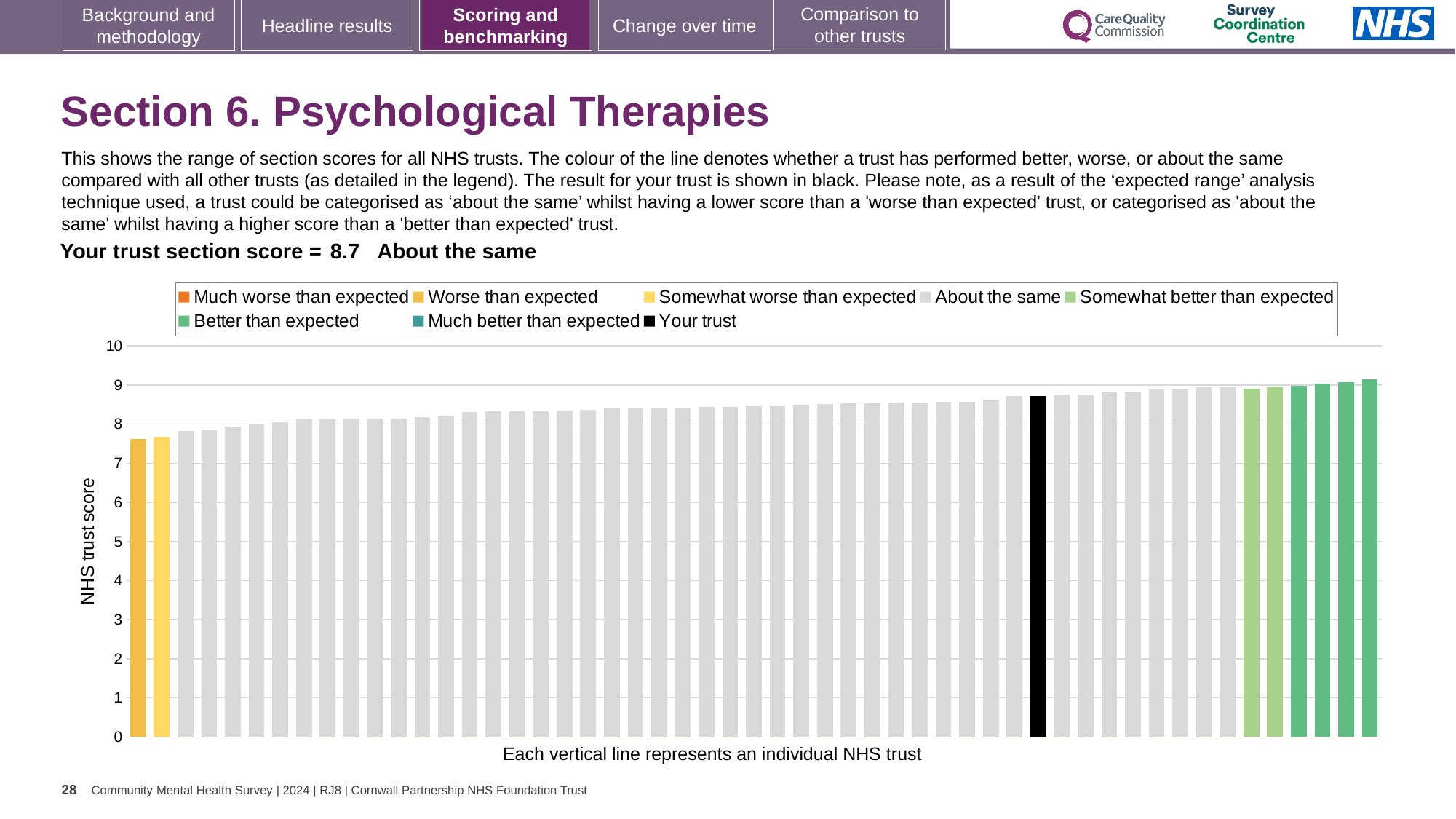
Is the value for the leftmost (lowest) trust bar greater or less than 8? less Which bar is higher, the leftmost bar or the rightmost bar? the rightmost bar What is the section score for your trust shown on the slide? 8.7 What kind of chart is shown on the slide? bar chart What is the label on the vertical axis of the chart? NHS trust score Is the value for the rightmost (highest) trust bar greater or less than 10? less Is the value for your trust greater or less than 8? greater Which performance category is your trust placed in for Section 6? About the same How many entries does the chart legend list? 8 What colour is the bar representing your trust? black Do the trust scores rise or fall moving from left to right along the x axis? rise